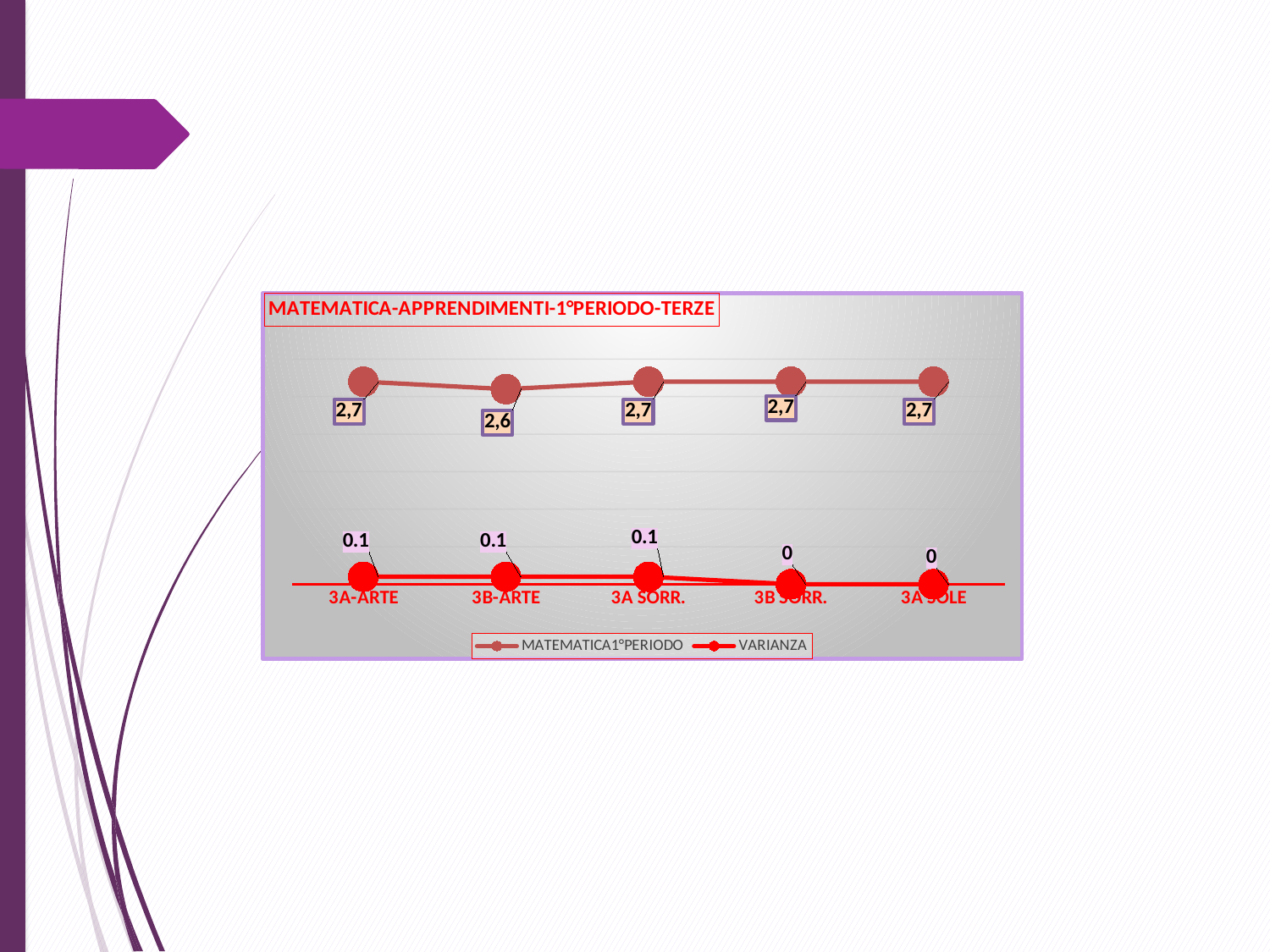
Which category has the lowest MATEMATICA1°PERIODO value? 3B-ARTE What is the difference between the MATEMATICA1°PERIODO values for 3A-ARTE and 3B-ARTE? 0,1 What is the MATEMATICA1°PERIODO value for 3B-ARTE? 2,6 What is the VARIANZA value for 3B SORR.? 0 Which series is drawn in bright red with circular markers along the bottom of the chart? VARIANZA What is the MATEMATICA1°PERIODO value for 3A SORR.? 2,7 How many categories are shown on the x axis? 5 What is the title of the chart? MATEMATICA-APPRENDIMENTI-1°PERIODO-TERZE Which is larger, the VARIANZA value for 3A SORR. or for 3A SOLE? 3A SORR. What is the VARIANZA value for 3A-ARTE? 0.1 What type of chart is shown on the slide? line chart How many series does the legend list? 2